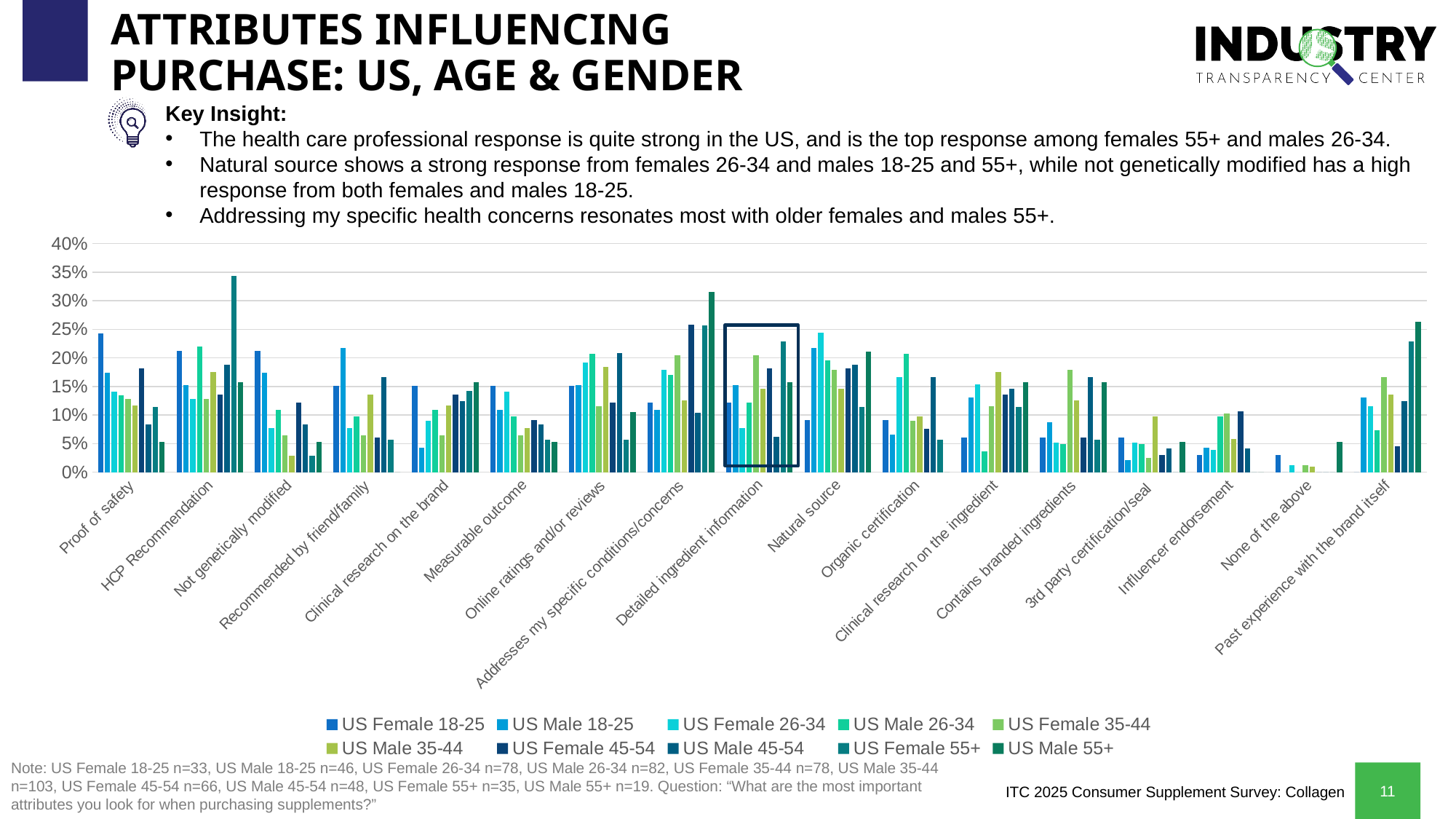
How many series does the legend list? 10 Is the value for US Female 18-25 under None of the above greater or less than 5%? less Which category on the x axis is outlined with a dark rectangle? Detailed ingredient information How many attribute categories are shown along the x axis? 17 For Proof of safety, which is larger: US Female 18-25 or US Male 18-25? US Female 18-25 Which series has the highest value for Proof of safety? US Female 18-25 Is the value for US Male 26-34 under HCP Recommendation greater or less than 30%? less Is the value for US Male 55+ under Past experience with the brand itself greater or less than 20%? greater Which series has the highest value for HCP Recommendation? US Female 55+ What kind of chart is shown on the slide? bar chart